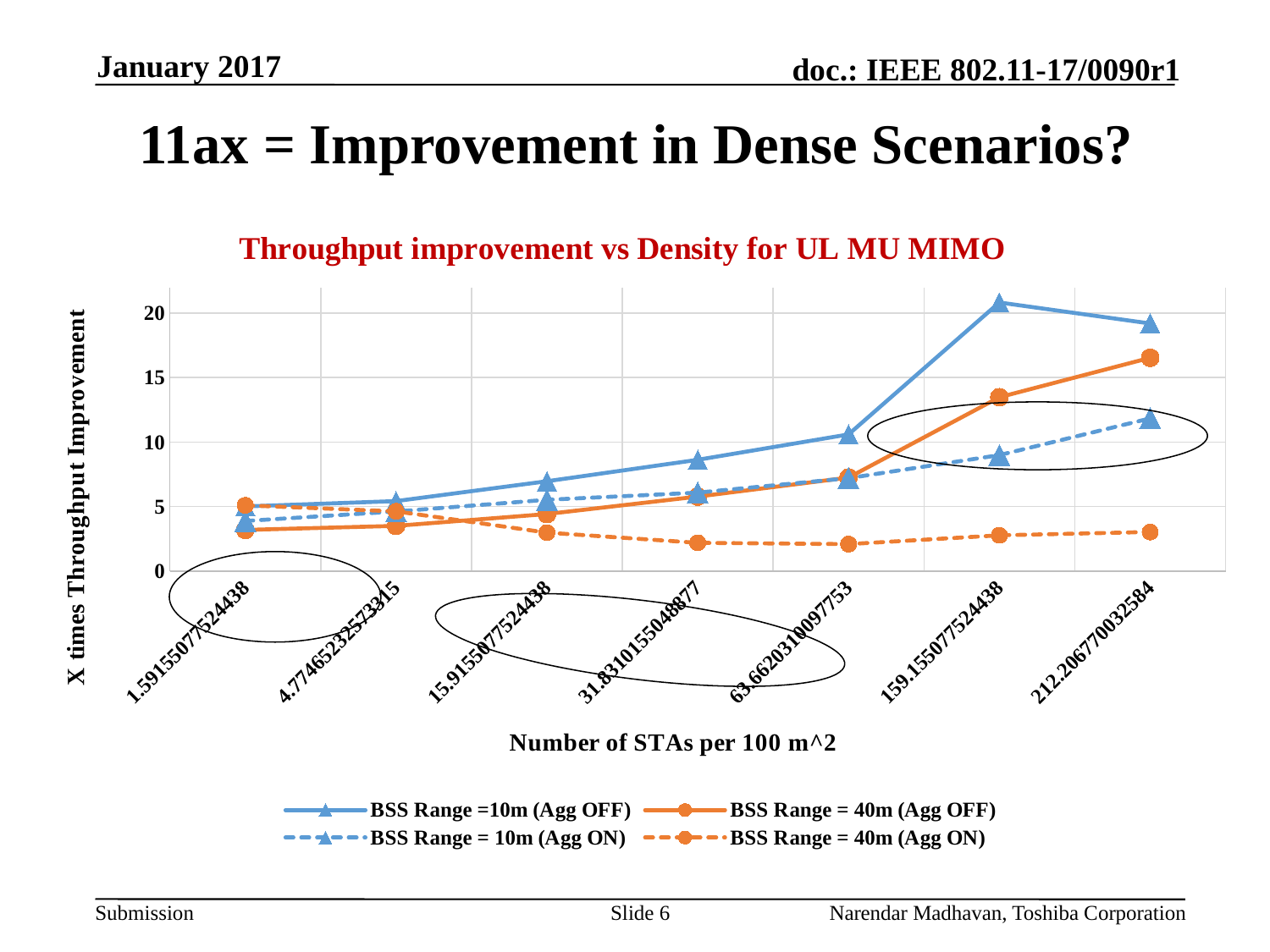
What is the title of the chart? Throughput improvement vs Density for UL MU MIMO At which x-axis value does the BSS Range = 40m (Agg OFF) series reach its highest point? 212.206770032584 What kind of chart is shown on the slide? line chart Is the value for BSS Range =10m (Agg OFF) at 159.155077524438 greater or less than 15? greater At which x-axis value does the BSS Range =10m (Agg OFF) series reach its highest point? 159.155077524438 Is the value for BSS Range = 10m (Agg ON) at 212.206770032584 greater or less than 10? greater Does the BSS Range = 40m (Agg OFF) series generally rise or fall as the number of STAs per 100 m^2 increases? rise Is the value for BSS Range = 40m (Agg ON) at 63.6620310097753 greater or less than 5? less How many x-axis categories (density values) are plotted? 7 What is the label of the x axis? Number of STAs per 100 m^2 At 159.155077524438 STAs per 100 m^2, which series has the larger value: BSS Range =10m (Agg OFF) or BSS Range = 40m (Agg OFF)? BSS Range =10m (Agg OFF) How many series does the legend list? 4